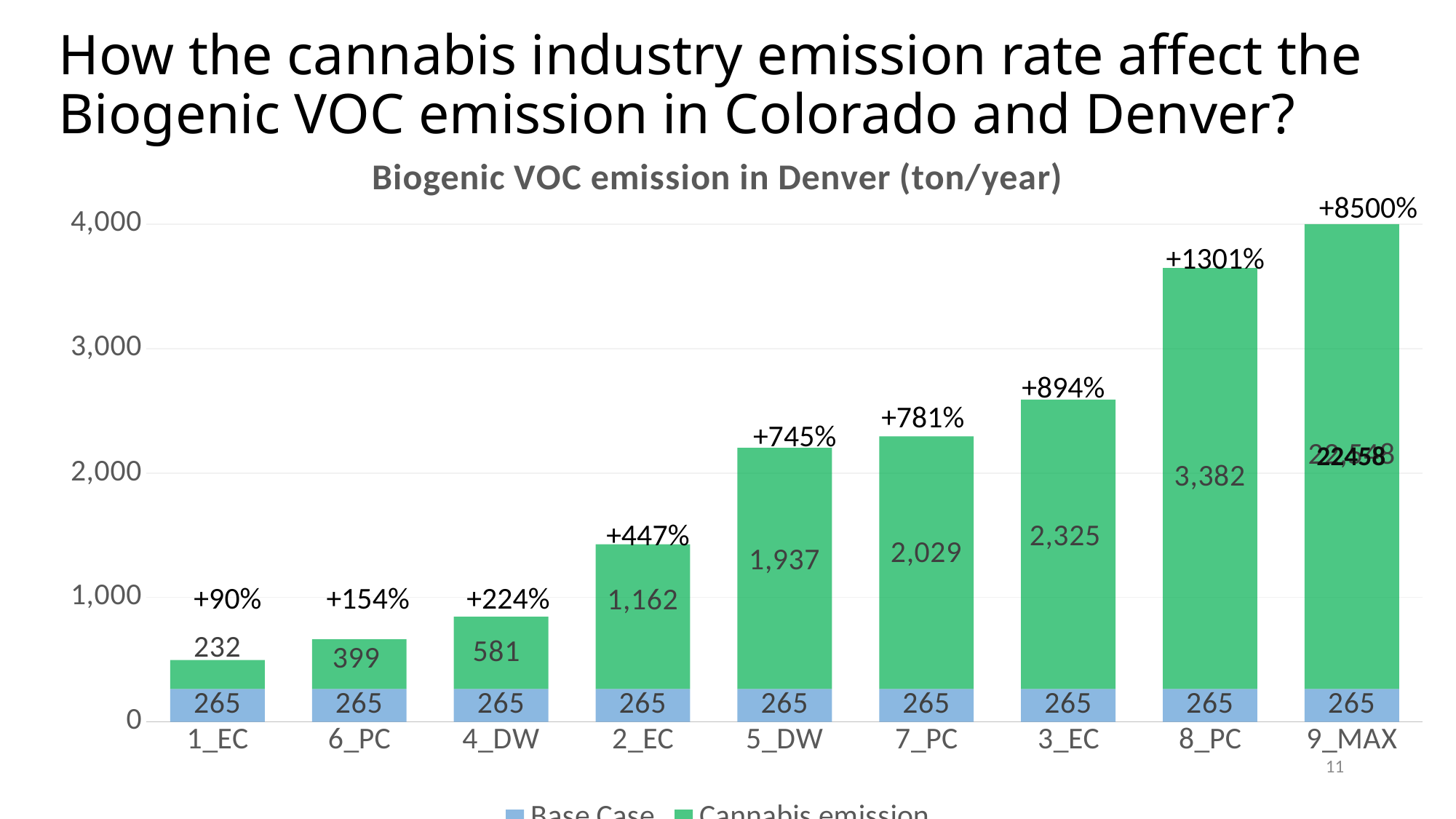
How many categories are shown on the x axis? 9 What is the total of the stacked bar for 1_EC? 497 Which has a larger Cannabis emission value, 5_DW or 7_PC? 7_PC How many series does the legend list? 2 What is the Cannabis emission value for 8_PC? 3,382 What is the difference between the Cannabis emission values for 8_PC and 1_EC? 3,150 Which category has the tallest bar overall? 9_MAX What is the Base Case value for 5_DW? 265 What percentage increase is labelled above the 3_EC bar? +894% What type of chart is shown on the slide? Stacked bar chart What is the Cannabis emission value for 2_EC? 1,162 Which category has the lowest Cannabis emission value? 1_EC